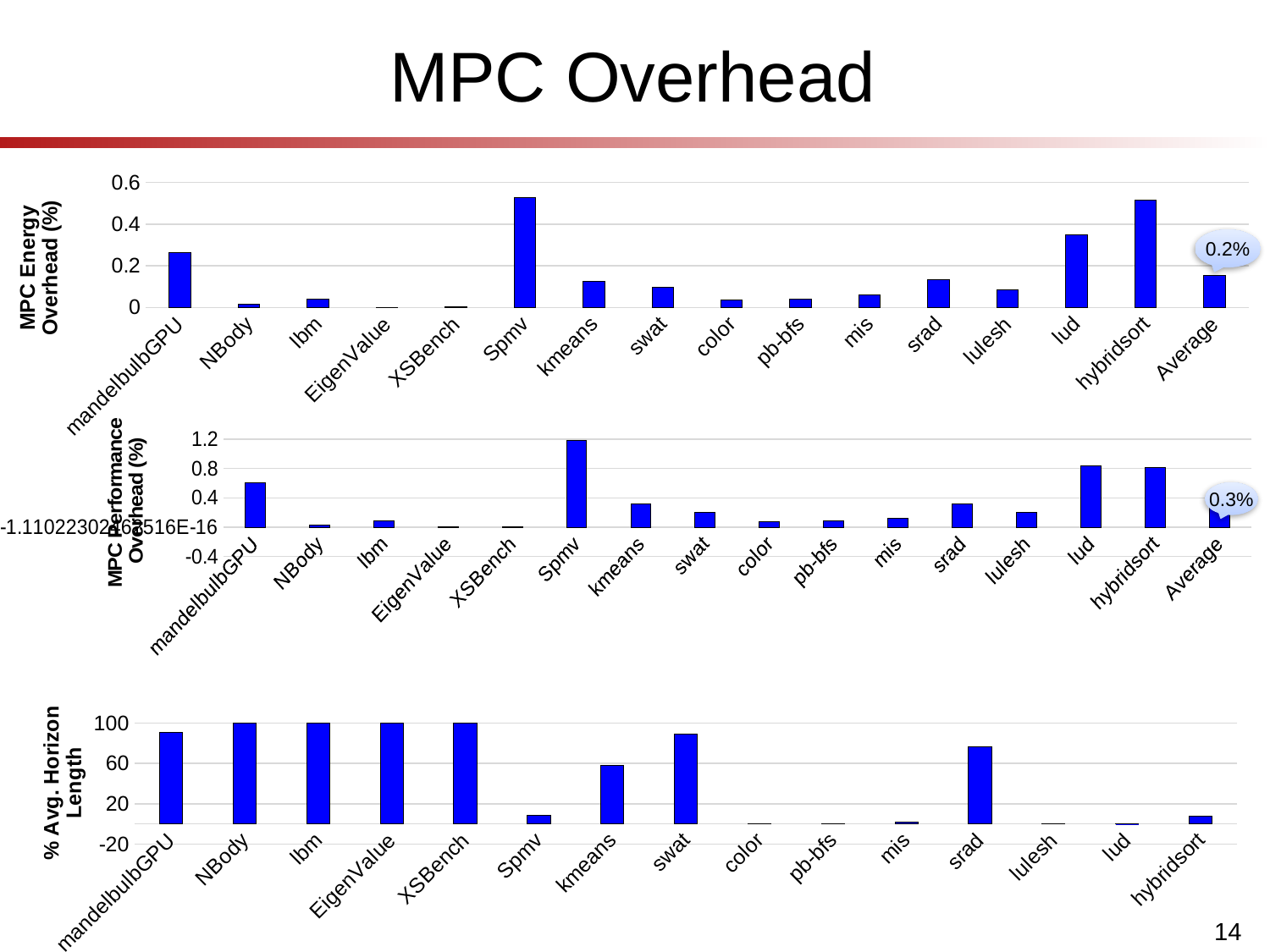
In the middle chart (MPC Performance Overhead), which category has the highest value? Spmv What kind of chart is the top chart (MPC Energy Overhead)? bar chart How many categories are shown on the x axis of the top chart (MPC Energy Overhead)? 16 In the bottom chart (% Avg. Horizon Length), is the value for Spmv greater or less than 20? less In the top chart (MPC Energy Overhead), what value is labelled for Average? 0.2% How many categories are shown on the x axis of the bottom chart (% Avg. Horizon Length)? 15 In the top chart (MPC Energy Overhead), is the value for lud greater or less than 0.2? greater In the middle chart (MPC Performance Overhead), what value is labelled for Average? 0.3% In the middle chart (MPC Performance Overhead), which is larger, Spmv or lud? Spmv In the top chart (MPC Energy Overhead), which is larger, lud or srad? lud In the bottom chart (% Avg. Horizon Length), is the value for mandelbulbGPU greater or less than 60? greater What is the y-axis label of the bottom chart? % Avg. Horizon Length